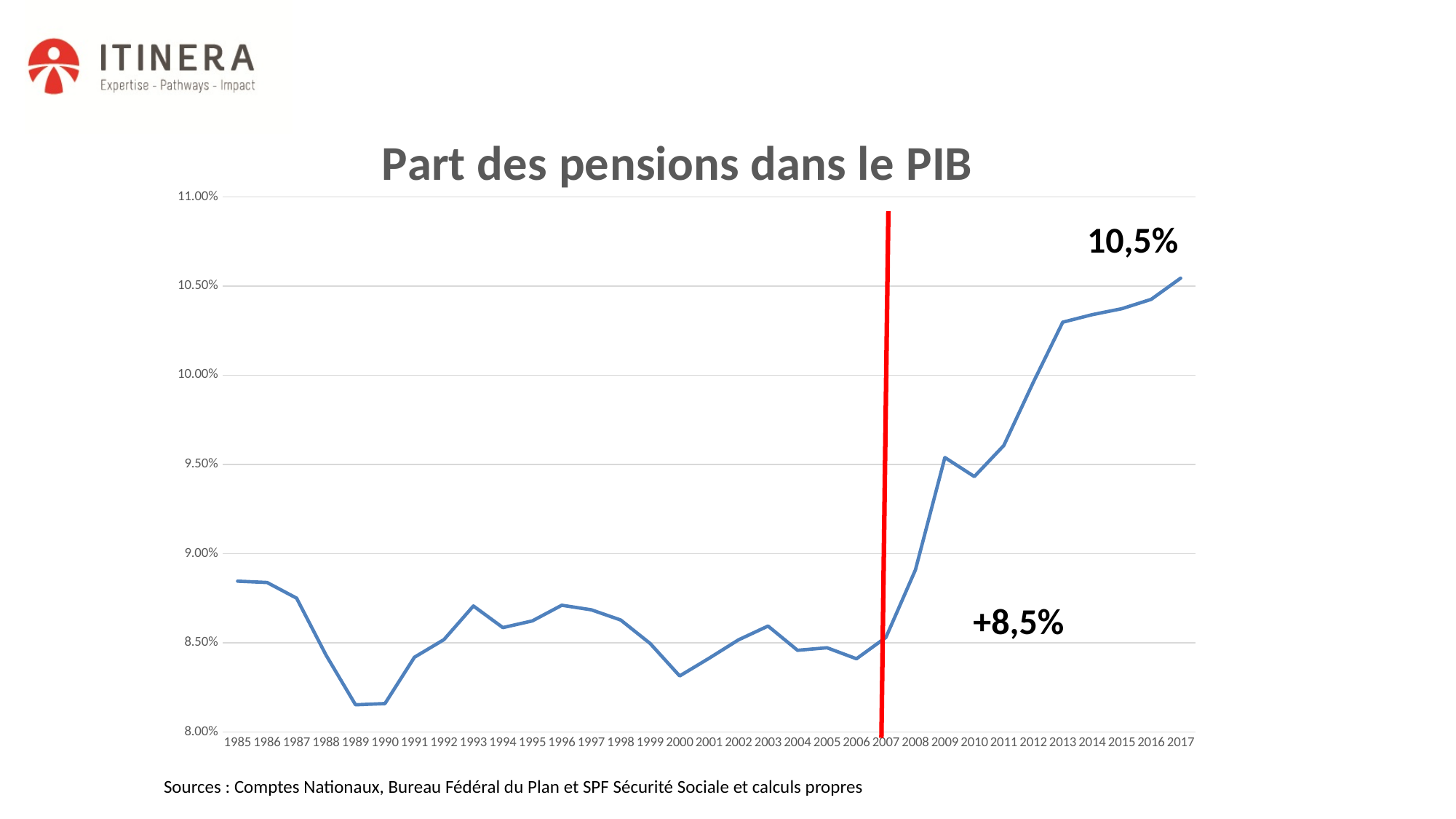
Which year has the highest value on the chart? 2017 Which is larger, the value for 2017 or the value for 1985? 2017 Is the value for 2013 greater or less than 10.00%? greater Is the value for 2000 greater or less than 8.50%? less What annotation is printed near the red vertical line at 2007? +8,5% What value is annotated at the end of the line near 2017? 10,5% What is the title of the chart? Part des pensions dans le PIB Does the line rise or fall between 2007 and 2017? rise What kind of chart is shown on the slide? line chart How many years are plotted along the x axis? 33 Is the value for 1985 greater or less than 8.50%? greater